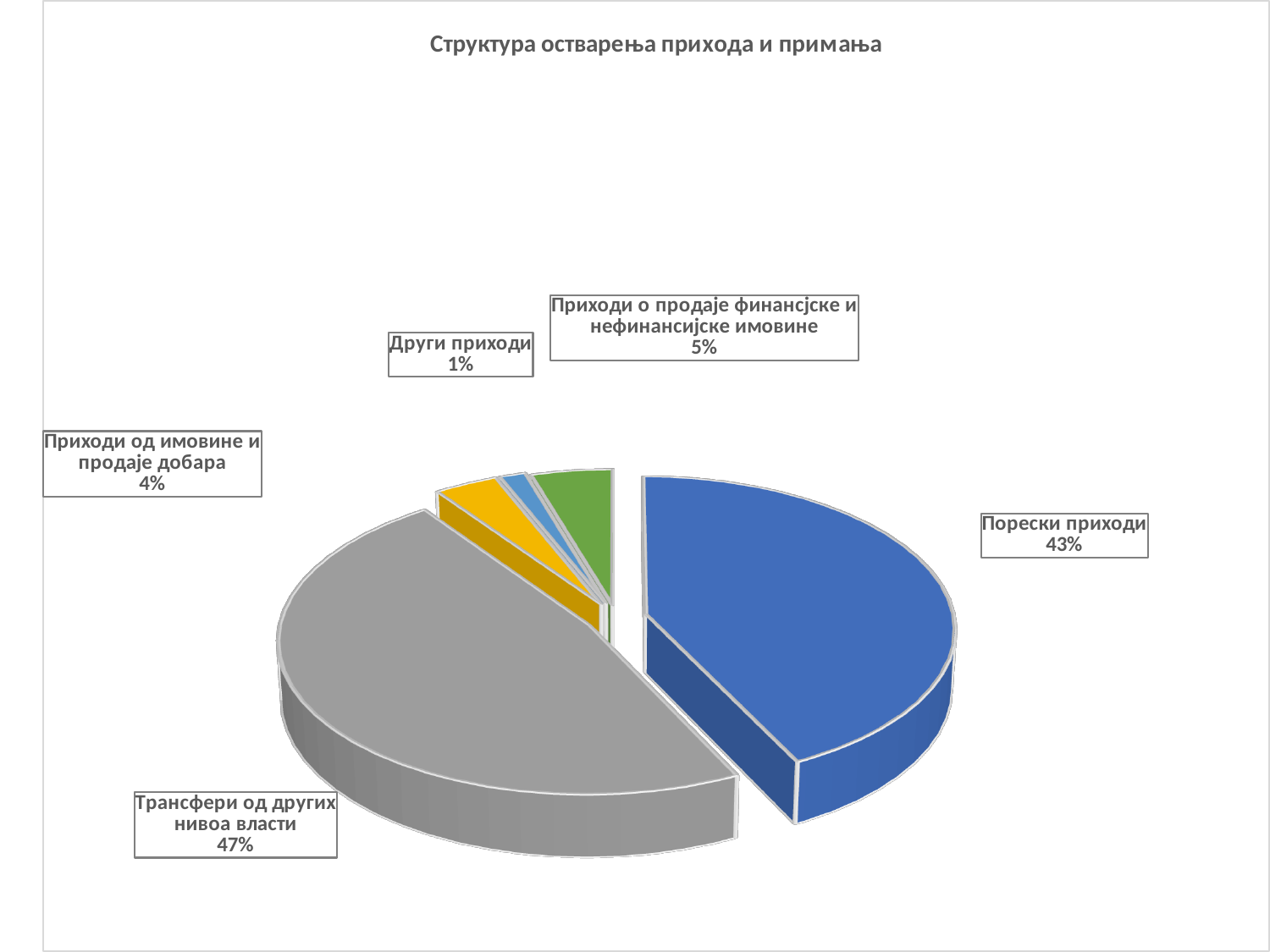
What kind of chart is shown on the slide? Pie chart Which category has the largest share of the pie? Трансфери од других нивоа власти What share of the pie is labelled Порески приходи? 43% What share of the pie is labelled Трансфери од других нивоа власти? 47% What percentage is shown for Приходи од имовине и продаје добара? 4% What percentage is shown for Приходи о продаје финансјске и нефинансијске имовине? 5% How many slices does the pie chart have? 5 What percentage is shown for Други приходи? 1% Which is larger, the share for Приходи о продаје финансјске и нефинансијске имовине or the share for Приходи од имовине и продаје добара? Приходи о продаје финансјске и нефинансијске имовине What is the difference in percentage points between Трансфери од других нивоа власти and Порески приходи? 4 Which category has the smallest share of the pie? Други приходи What is the title of the chart? Структура остварења прихода и примања